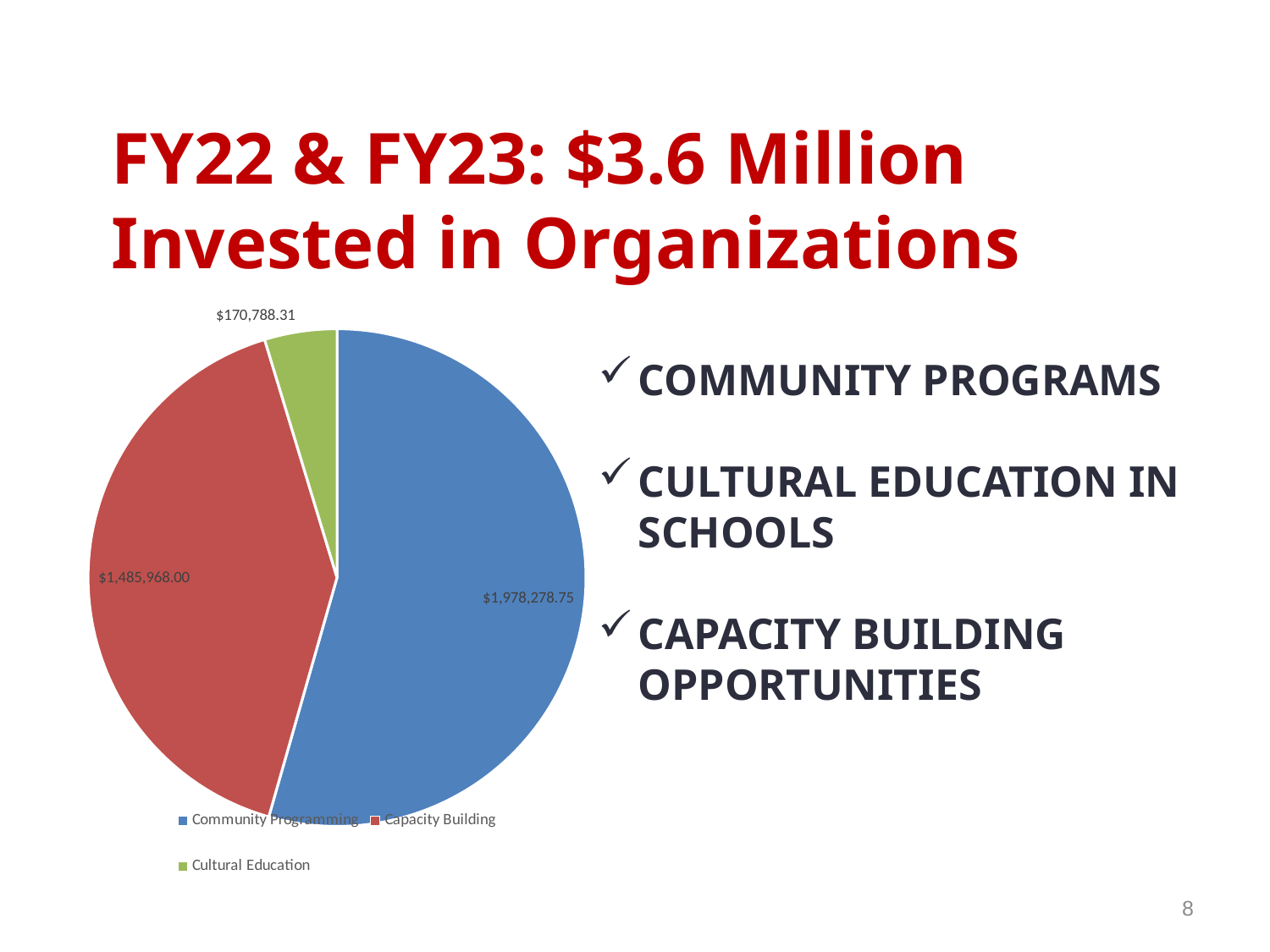
What is the difference between the Capacity Building and Cultural Education values? $1,315,179.69 How many entries does the legend of the pie chart list? 3 Which category has the largest slice in the pie chart? Community Programming Which is larger, the Capacity Building slice or the Cultural Education slice? Capacity Building What is the value of the Cultural Education slice in the pie chart? $170,788.31 What kind of chart is shown on the slide? Pie chart What colour is the Capacity Building slice in the pie chart? Red Which category has the smallest slice in the pie chart? Cultural Education What is the difference between the Community Programming and Capacity Building values? $492,310.75 What is the value of the Capacity Building slice in the pie chart? $1,485,968.00 How many slices does the pie chart have? 3 What is the value of the Community Programming slice in the pie chart? $1,978,278.75